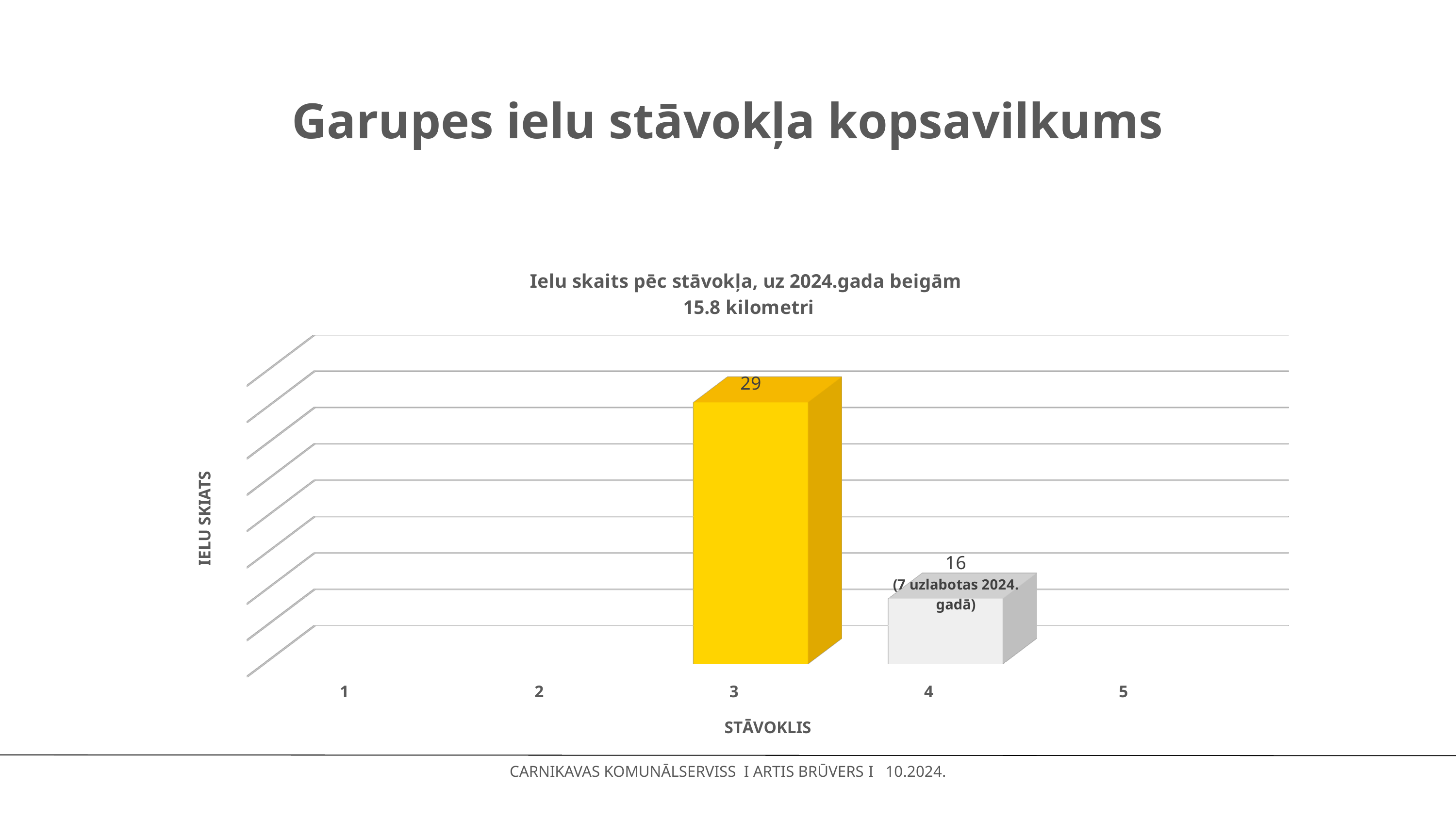
Which condition category has the highest number of streets? 3 What is the difference between the values for condition 3 and condition 4? 13 What is the label of the x axis? STĀVOKLIS How many condition categories are shown on the x axis? 5 Which is larger, the value for condition 3 or the value for condition 4? Condition 3 What kind of chart is shown on the slide? Bar chart What is the title of the chart? Ielu skaits pēc stāvokļa, uz 2024.gada beigām 15.8 kilometri What colour is the bar for condition 3? Yellow How many categories have a bar with a data label? 2 What is the value for condition (stāvoklis) 4? 16 What is the value for condition (stāvoklis) 3? 29